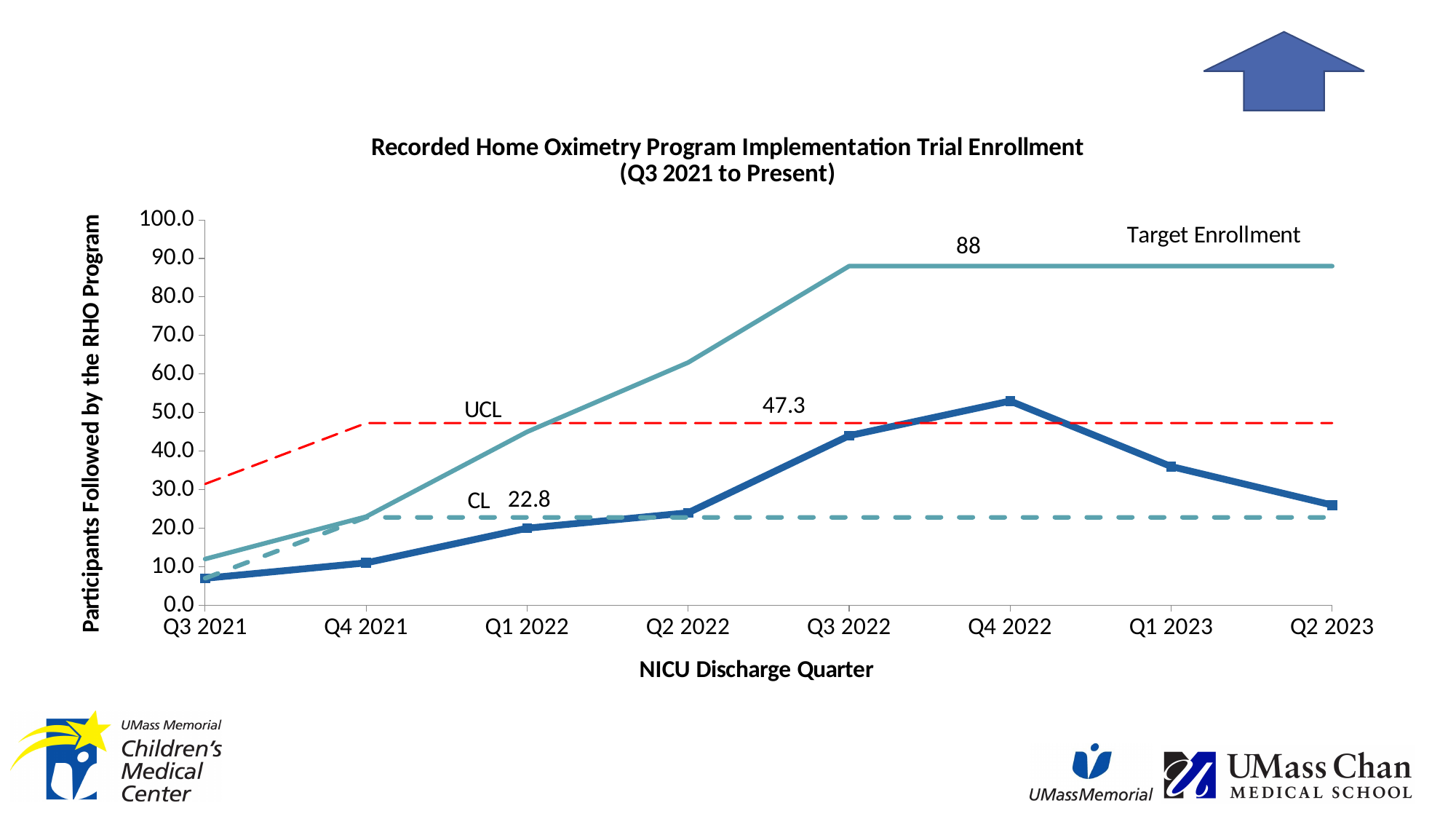
What is the value of the UCL line? 47.3 In which quarter is the number of participants followed by the RHO Program lowest? Q3 2021 What is the value of the CL line? 22.8 In which quarter is the number of participants followed by the RHO Program highest? Q4 2022 What kind of chart is shown on the slide? line chart Which quarter has more participants followed by the RHO Program, Q3 2022 or Q1 2023? Q3 2022 Is the number of participants in Q1 2023 greater or less than 40? less What is the Target Enrollment value labelled on the chart from Q3 2022 onward? 88 How many NICU discharge quarters are shown on the x axis? 8 What is the difference between the Target Enrollment value (88) and the UCL value (47.3)? 40.7 Is the number of participants in Q4 2022 greater or less than 50? greater What is the title of the x axis? NICU Discharge Quarter